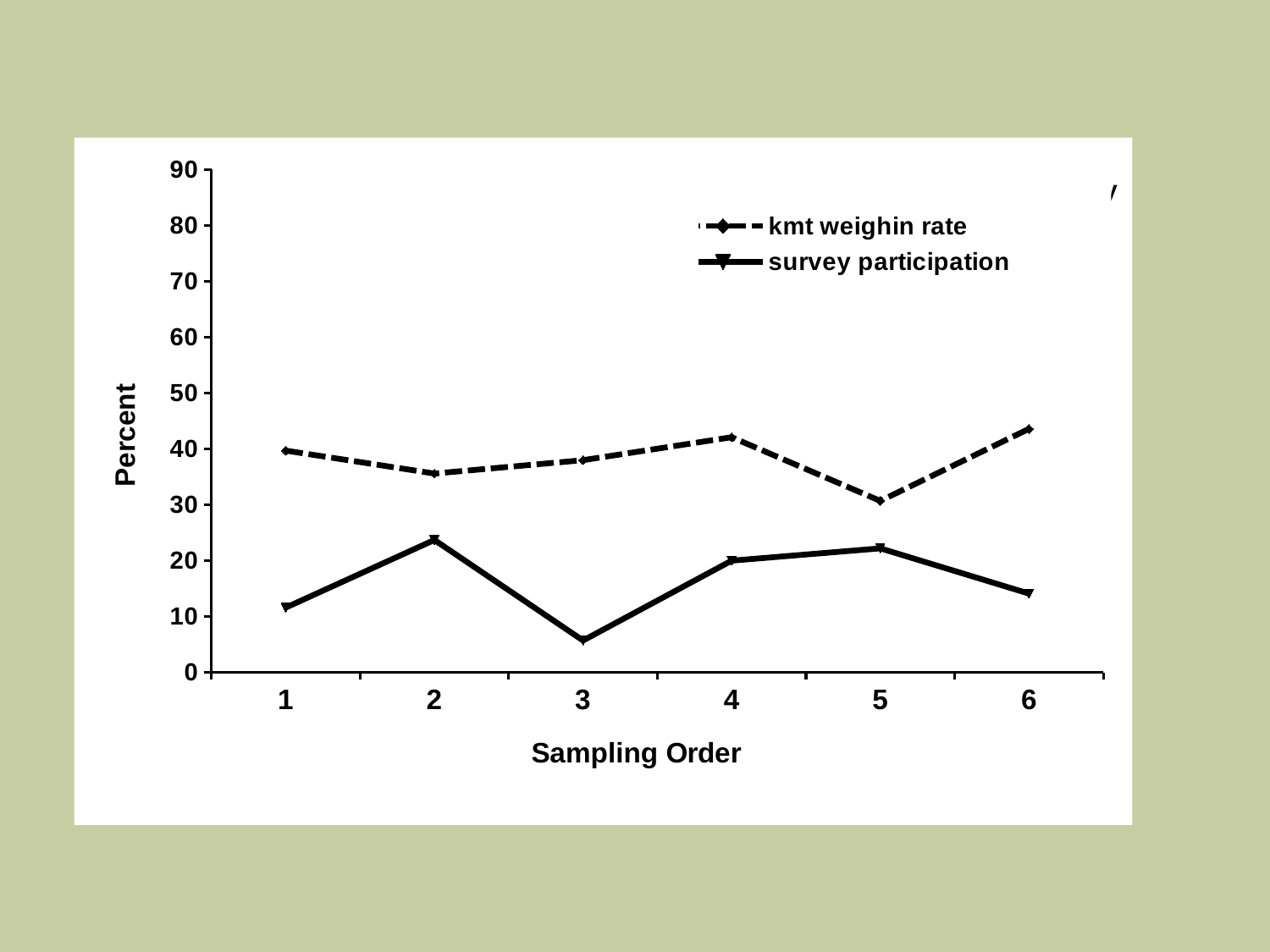
What kind of chart is shown on the slide? line chart How many series does the legend list? 2 Is survey participation at sampling order 3 greater or less than 10? less Is the kmt weighin rate at sampling order 5 greater or less than 40? less What is the label of the y axis? Percent How many sampling order points are plotted along the x axis? 6 Is the kmt weighin rate at sampling order 6 greater or less than 40? greater At sampling order 3, which series has the higher value, kmt weighin rate or survey participation? kmt weighin rate At which sampling order is the kmt weighin rate lowest? 5 Which series is drawn with a dashed line? kmt weighin rate Does survey participation rise or fall from sampling order 2 to sampling order 3? fall At which sampling order is survey participation lowest? 3